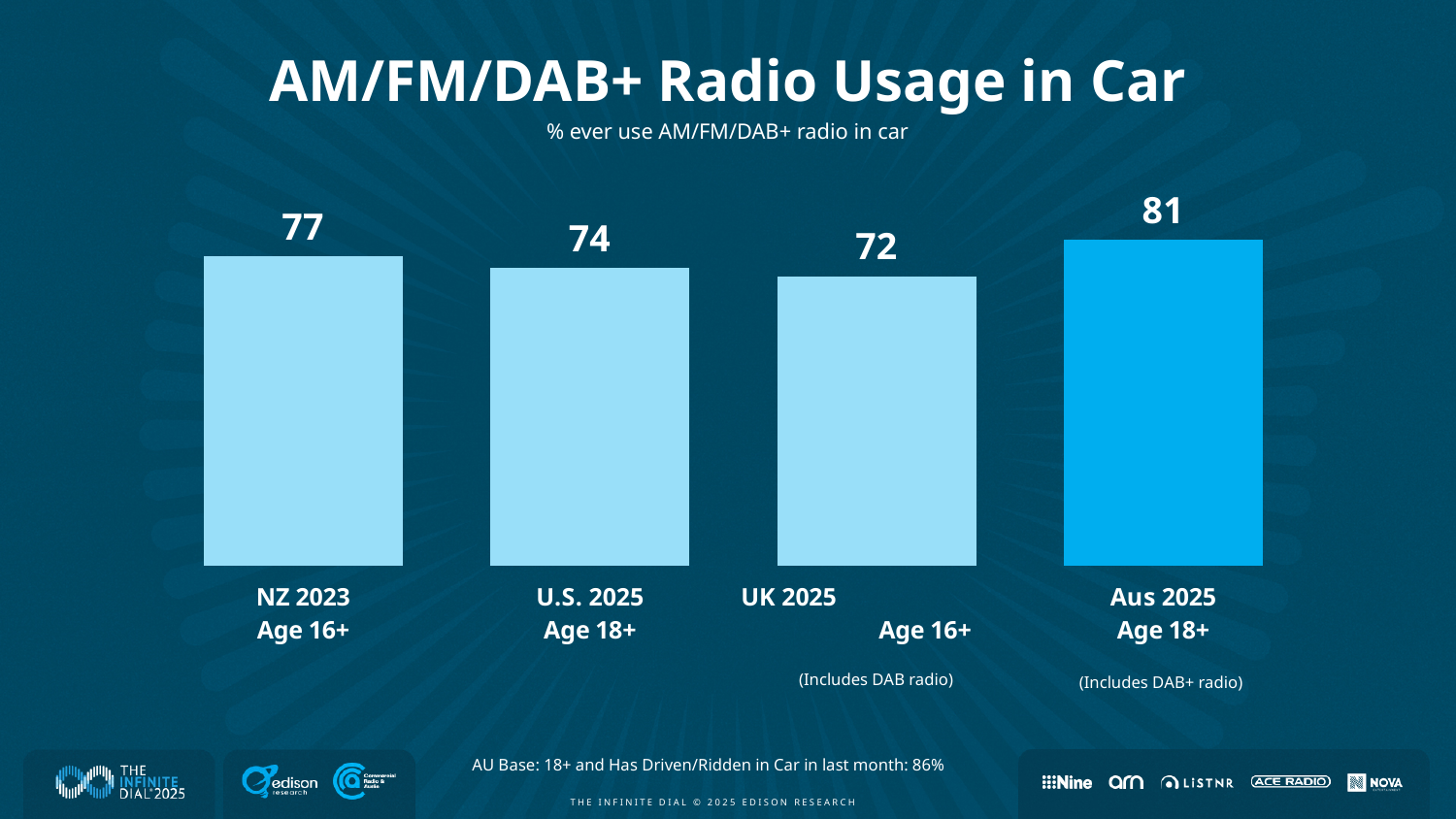
Which category has the highest value? Aus 2025 What is the value for UK 2025? 72 What is the value for U.S. 2025? 74 How many categories are shown in the chart? 4 Which is larger, the value for NZ 2023 or the value for U.S. 2025? NZ 2023 What is the difference between the values for Aus 2025 and UK 2025? 9 What is the value for Aus 2025? 81 What is the value for NZ 2023? 77 What kind of chart is shown on the slide? Bar chart What is the title of the chart? AM/FM/DAB+ Radio Usage in Car What is the difference between the values for NZ 2023 and U.S. 2025? 3 Which category has the lowest value? UK 2025